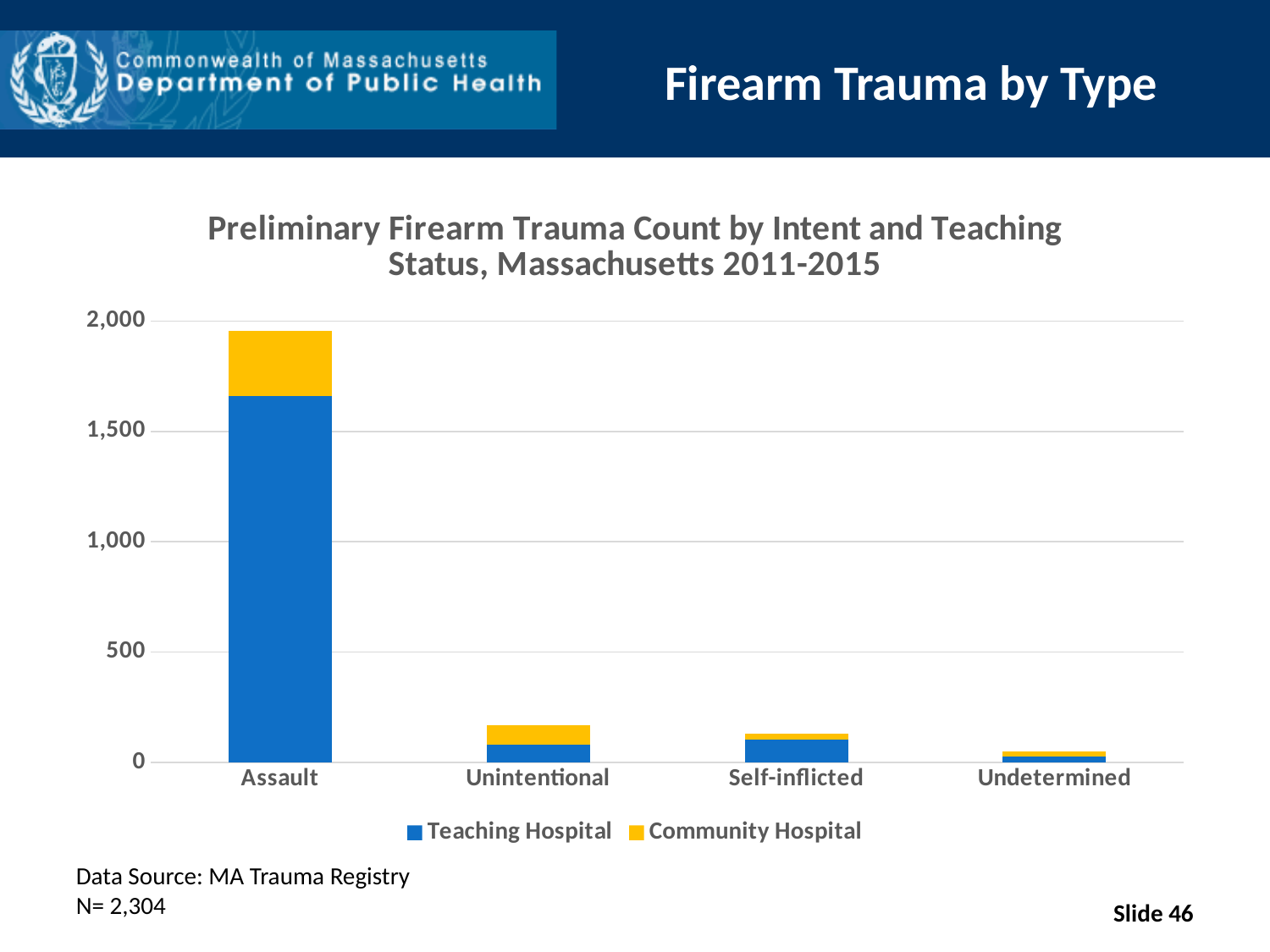
Is the total value for Assault greater or less than 1,500? greater How many series does the legend list? 2 Which intent category has the highest total firearm trauma count? Assault How many intent categories are shown on the x axis? 4 What kind of chart is shown on the slide? Stacked bar chart What is the title of the chart? Preliminary Firearm Trauma Count by Intent and Teaching Status, Massachusetts 2011-2015 Is the Teaching Hospital value for Assault greater or less than 1,500? greater Which intent category has the lowest total firearm trauma count? Undetermined Which series is shown in yellow? Community Hospital Which has a larger total count, Assault or Unintentional? Assault Is the total value for Unintentional greater or less than 500? less Which has a larger total count, Self-inflicted or Undetermined? Self-inflicted